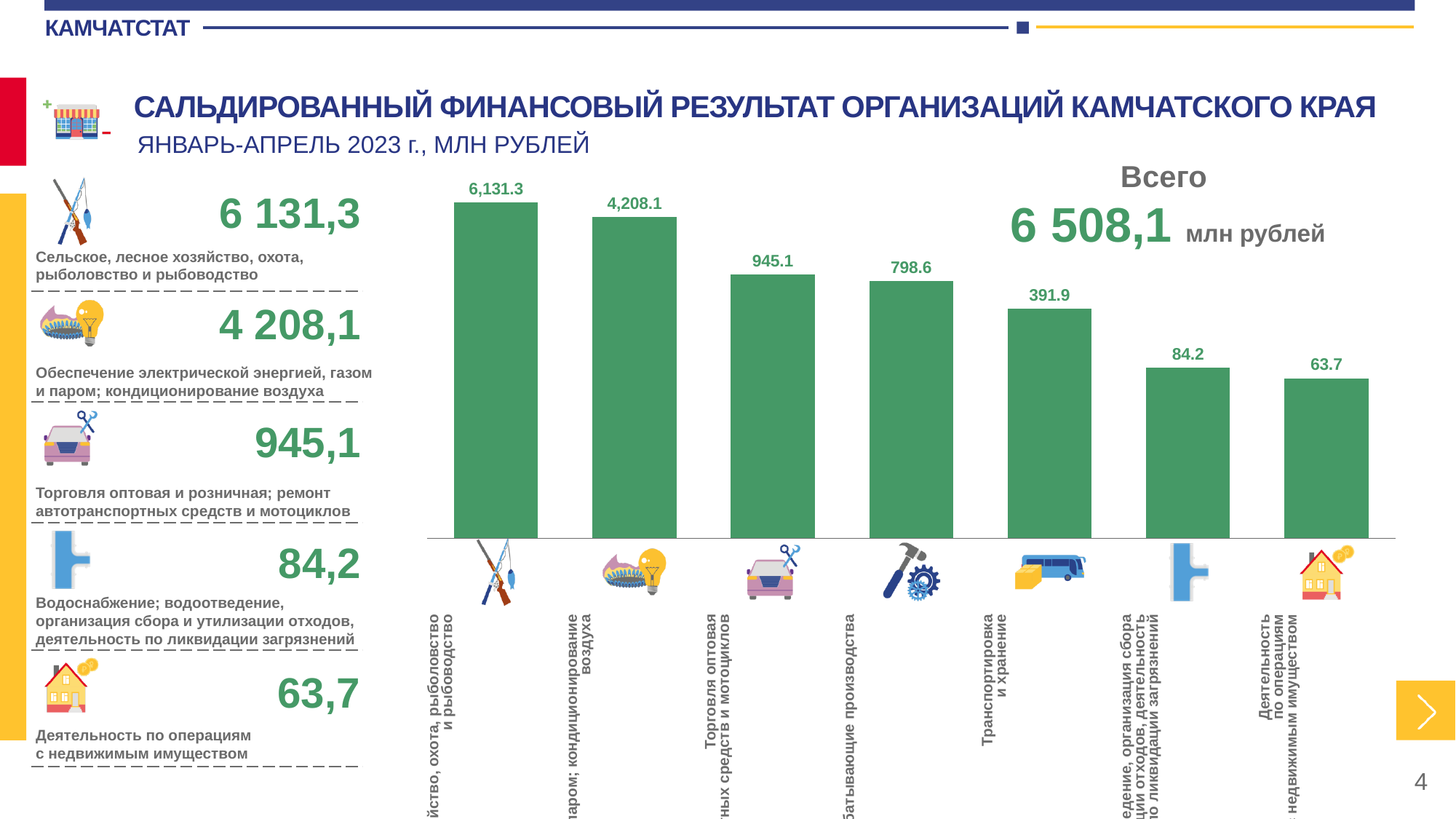
What is the value of the fourth bar from the left? 798.6 Do the bar values rise or fall from left to right along the x axis? fall What is the value of the bar for Транспортировка и хранение? 391.9 What is the difference between the bars for Водоснабжение; водоотведение (84.2) and Деятельность по операциям с недвижимым имуществом (63.7)? 20.5 Which category has the highest bar? Сельское, лесное хозяйство, охота, рыболовство и рыбоводство What is the value of the bar for Торговля оптовая и розничная; ремонт автотранспортных средств и мотоциклов? 945.1 What total value (Всего) is printed on the slide next to the chart? 6 508,1 млн рублей Which category has the lowest bar? Деятельность по операциям с недвижимым имуществом What kind of chart is shown on the slide? bar chart How many bars (categories) does the chart show? 7 Which is larger: the bar for Водоснабжение; водоотведение or the bar for Деятельность по операциям с недвижимым имуществом? Водоснабжение; водоотведение What is the difference between the first bar (6,131.3) and the second bar (4,208.1)? 1,923.2